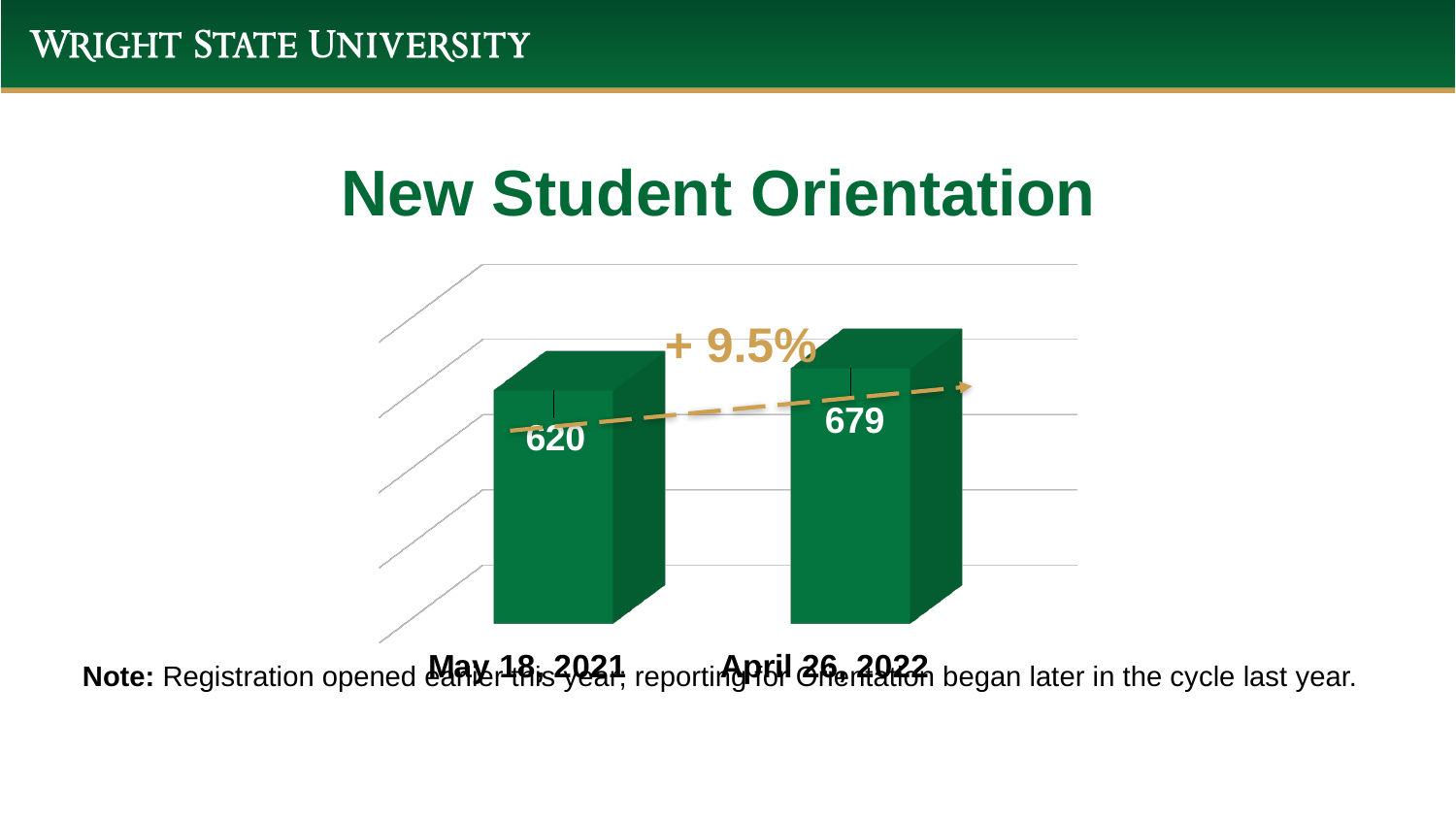
What percentage change is annotated on the chart? + 9.5% Which category has the highest value? April 26, 2022 What is the title of the chart? New Student Orientation How many bars are shown in the chart? 2 What kind of chart is shown on the slide? bar chart What is the difference between the values for April 26, 2022 and May 18, 2021? 59 Do the values rise or fall from May 18, 2021 to April 26, 2022? rise Which is larger, the value for May 18, 2021 or the value for April 26, 2022? April 26, 2022 What is the value for May 18, 2021? 620 Which category has the lowest value? May 18, 2021 What is the value for April 26, 2022? 679